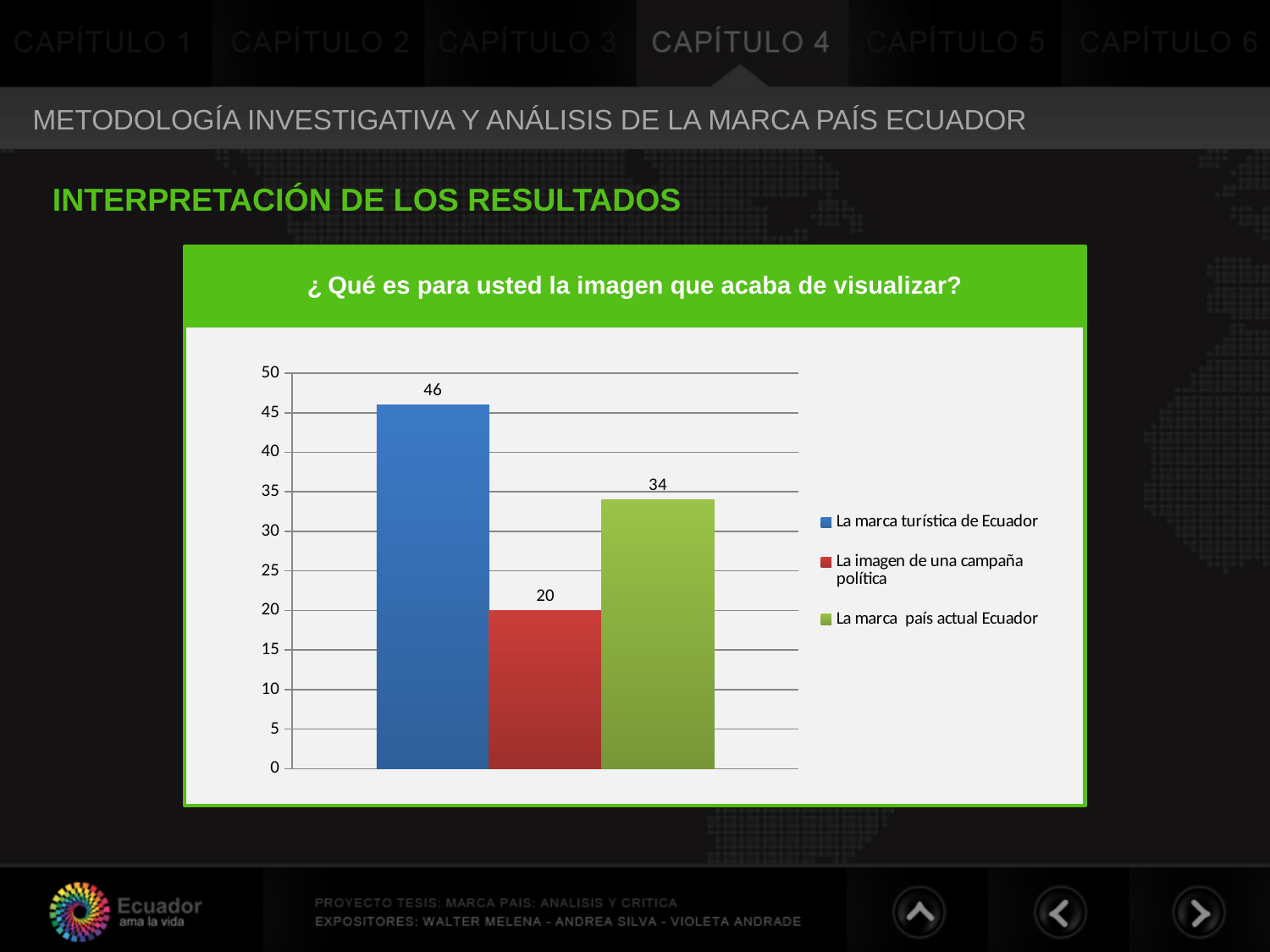
What is the difference between the values for "La marca turística de Ecuador" and "La marca país actual Ecuador"? 12 How many series does the legend list? 3 What kind of chart is shown on the slide? bar chart What is the title of the chart? ¿ Qué es para usted la imagen que acaba de visualizar? What is the value for "La marca turística de Ecuador"? 46 Which is larger, the value for "La marca país actual Ecuador" or for "La imagen de una campaña política"? La marca país actual Ecuador What is the value for "La marca país actual Ecuador"? 34 Which series has the highest value? La marca turística de Ecuador What is the value for "La imagen de una campaña política"? 20 Is the value for "La marca turística de Ecuador" greater or less than 40? greater What is the difference between the values for "La marca país actual Ecuador" and "La imagen de una campaña política"? 14 Which series has the lowest value? La imagen de una campaña política